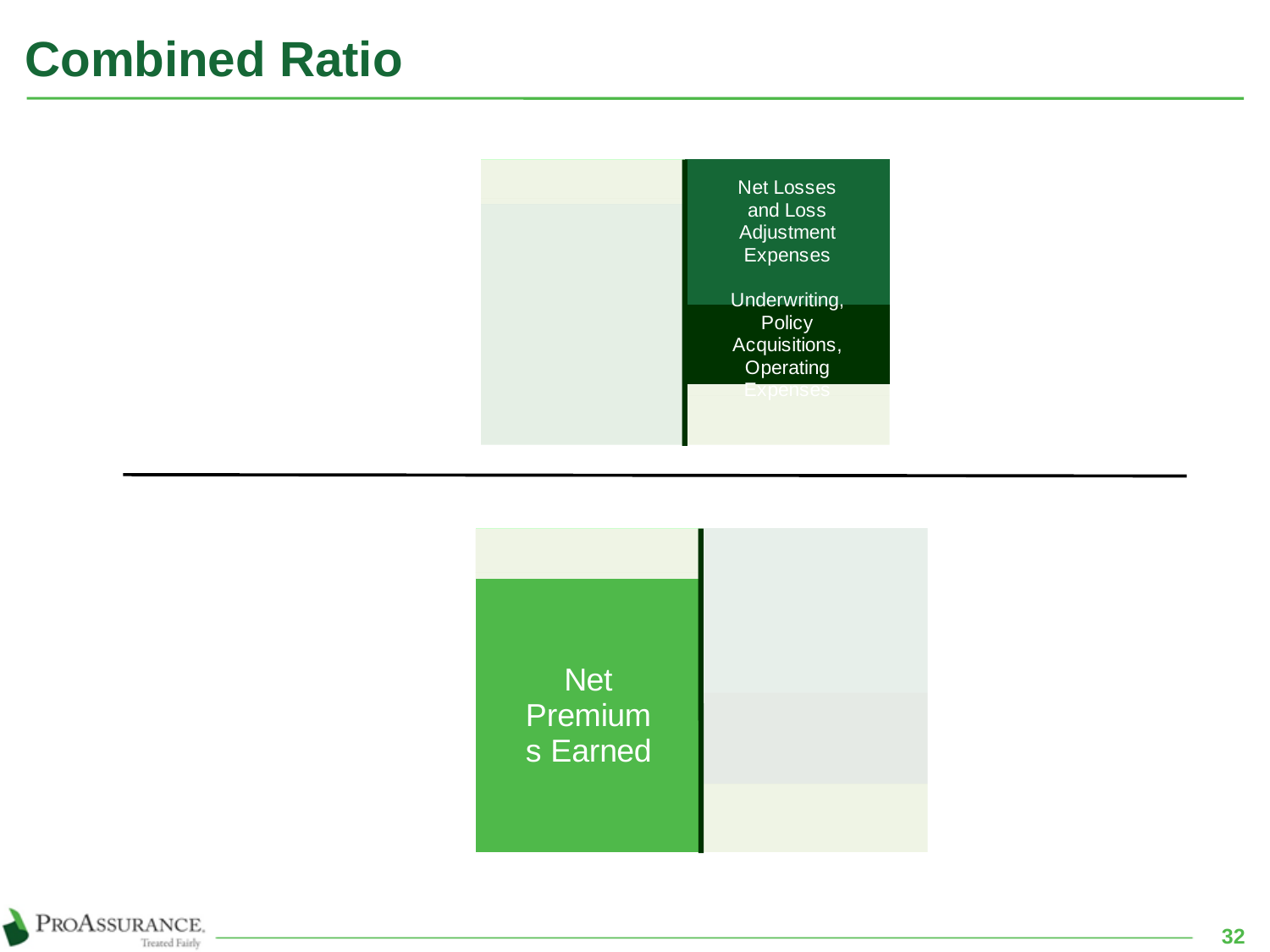
In the upper chart, which segment is larger: Net Losses and Loss Adjustment Expenses or Underwriting, Policy Acquisitions, Operating Expenses? Net Losses and Loss Adjustment Expenses What kind of chart is shown in the lower chart on the slide? bar chart In the lower chart, what is the label on the single bar? Net Premiums Earned What kind of chart is shown in the upper chart on the slide? bar chart In the upper chart, which segment sits at the top of the stacked bar? Net Losses and Loss Adjustment Expenses In the upper chart, which segment is the largest? Net Losses and Loss Adjustment Expenses In the upper chart, how many labelled segments make up the stacked bar? 2 How many bars are plotted in the lower chart? 2